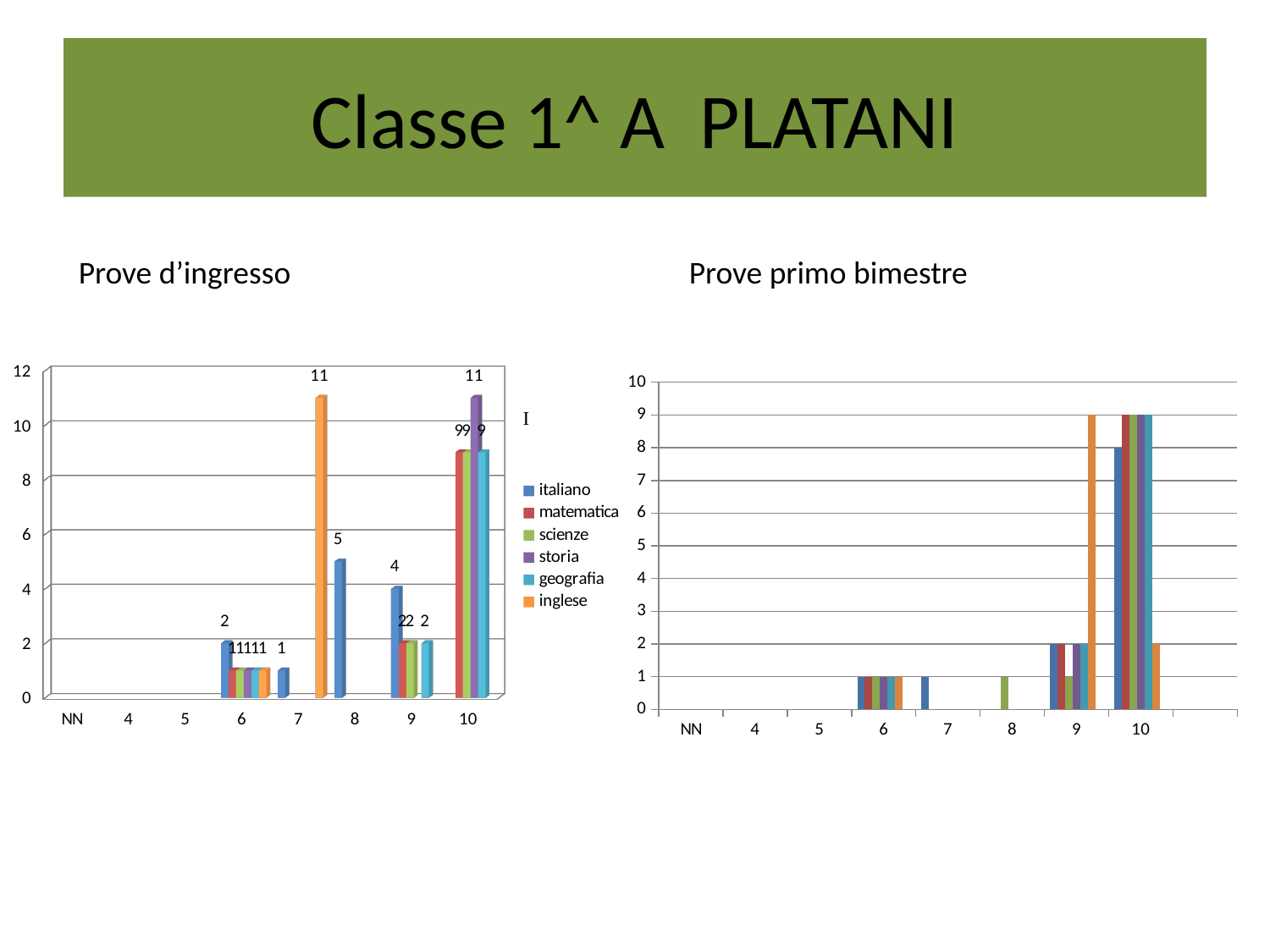
In the 'Prove d'ingresso' chart, what is the difference between the italiano value at category 8 and the italiano value at category 9? 1 How many series does the legend list? 6 In the 'Prove d'ingresso' chart, what is the value for inglese at category 7? 11 How many categories are shown on the x axis of the 'Prove primo bimestre' chart? 8 In the 'Prove d'ingresso' chart, what is the value for storia at category 10? 11 Which series is shown in orange in the legend? inglese In the 'Prove primo bimestre' chart, is the value for inglese at category 10 greater or less than 5? less In the 'Prove d'ingresso' chart, which is larger: the italiano value at category 6 or the italiano value at category 7? italiano at 6 In the 'Prove primo bimestre' chart, what is the value for italiano at category 10? 8 What kind of chart is the 'Prove primo bimestre' chart? bar chart In the 'Prove primo bimestre' chart, what is the value for inglese at category 9? 9 In the 'Prove d'ingresso' chart, what is the value for italiano at category 8? 5